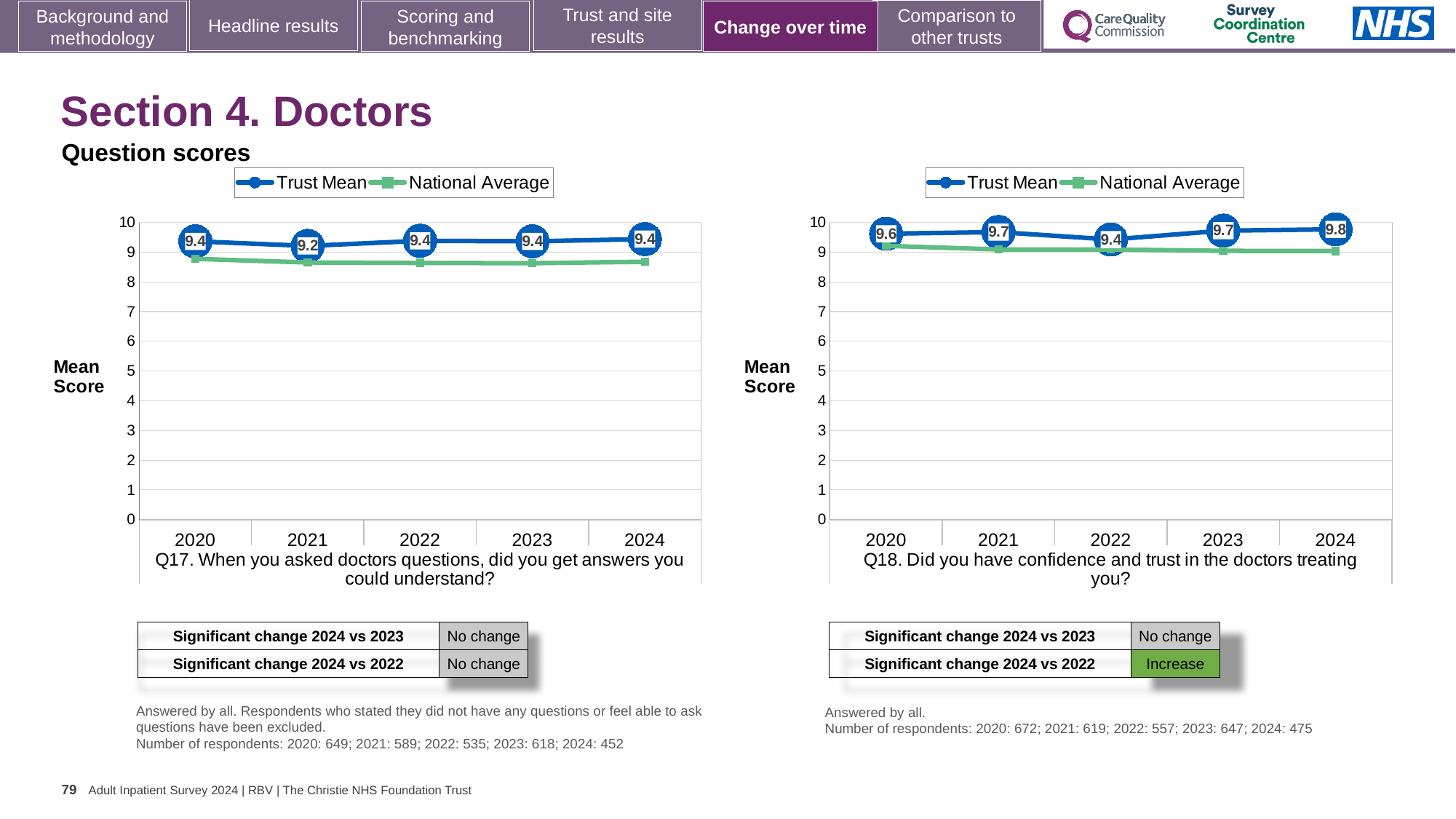
How many years are shown on the x axis of the Q17 chart? 5 In the Q18 chart, what is the Trust Mean score for 2024? 9.8 In the Q17 chart, is the National Average value for 2022 greater or less than 9? less In the Q18 chart, what is the difference between the Trust Mean scores for 2024 and 2022? 0.4 How many series does the legend of the Q18 chart list? 2 In the Q18 chart, what is the Trust Mean score for 2022? 9.4 In the Q18 chart, is the Trust Mean score for 2020 larger or smaller than the Trust Mean score for 2022? larger In the Q18 chart, does the Trust Mean rise or fall from 2022 to 2024? rise In the Q17 chart, what is the Trust Mean score for 2021? 9.2 What kind of chart is used for Q17? line chart In the Q18 chart, which year has the highest Trust Mean score? 2024 In the Q17 chart, which year has the lowest Trust Mean score? 2021